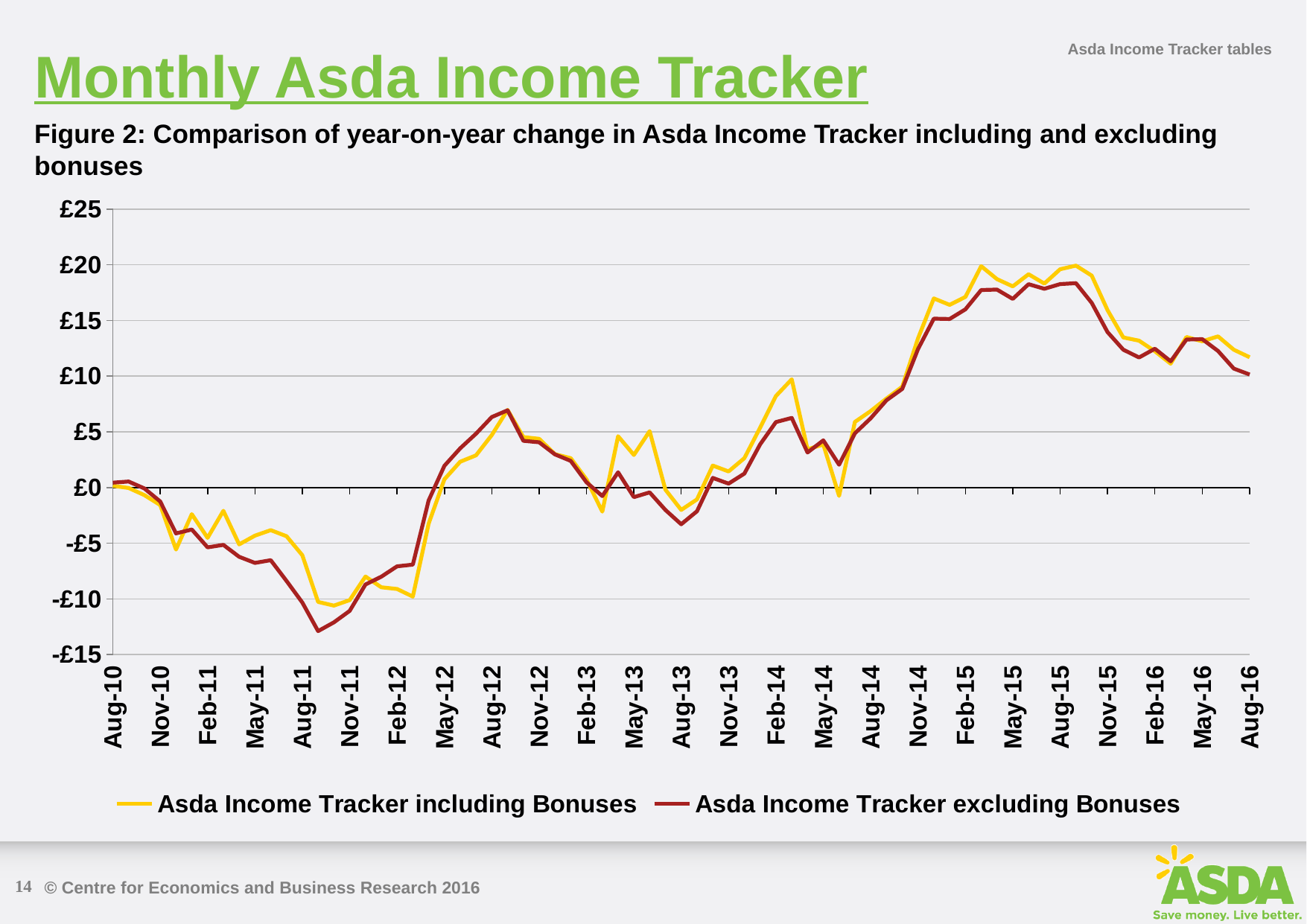
At Feb-14, which series has the higher value: including Bonuses or excluding Bonuses? Asda Income Tracker including Bonuses Which series is drawn in yellow? Asda Income Tracker including Bonuses Is the value for Asda Income Tracker excluding Bonuses at Aug-13 greater or less than £0? less What is the figure title of the chart? Figure 2: Comparison of year-on-year change in Asda Income Tracker including and excluding bonuses How many series does the legend list? 2 Is the value for Asda Income Tracker including Bonuses at Feb-15 greater or less than £15? greater What kind of chart is shown on the slide? Line chart Is the value for Asda Income Tracker including Bonuses at Aug-16 greater or less than £10? greater At Feb-12, which series has the higher value: including Bonuses or excluding Bonuses? Asda Income Tracker excluding Bonuses Do the values for Asda Income Tracker excluding Bonuses rise or fall between Aug-10 and Aug-11? Fall